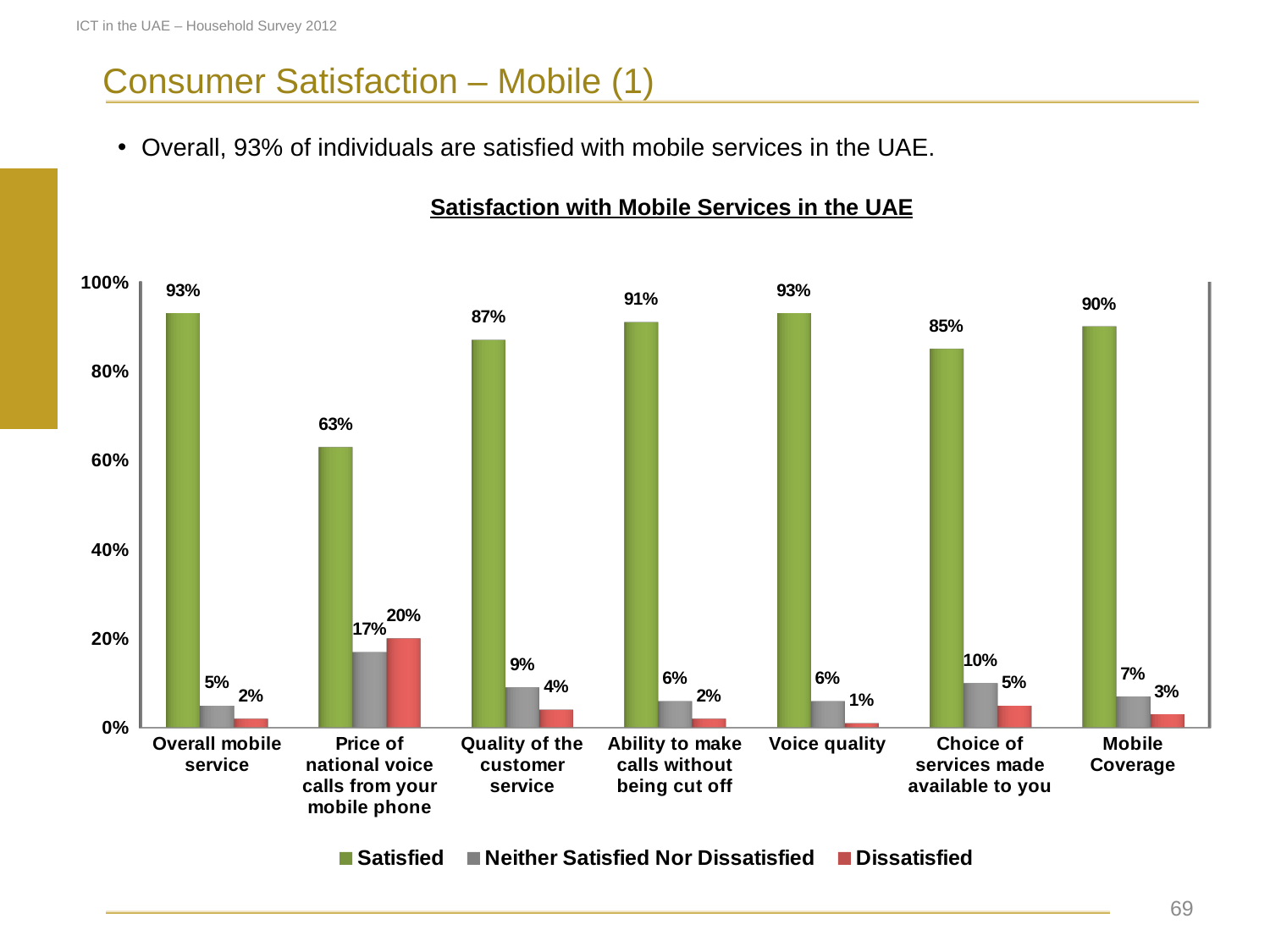
How many categories are shown on the x axis? 7 What kind of chart is shown on the slide? Bar chart Which category has the lowest Satisfied value? Price of national voice calls from your mobile phone Which is larger, the Satisfied value for Quality of the customer service or for Ability to make calls without being cut off? Ability to make calls without being cut off What is the title of the chart? Satisfaction with Mobile Services in the UAE What is the Dissatisfied value for Voice quality? 1% How many series does the legend list? 3 What colour represents the Dissatisfied series? Red What percentage of respondents are satisfied with the price of national voice calls from their mobile phone? 63% What is the difference between the Satisfied values for Overall mobile service and Mobile Coverage? 3% What is the Neither Satisfied Nor Dissatisfied value for Choice of services made available to you? 10% Which category has the highest Dissatisfied value? Price of national voice calls from your mobile phone